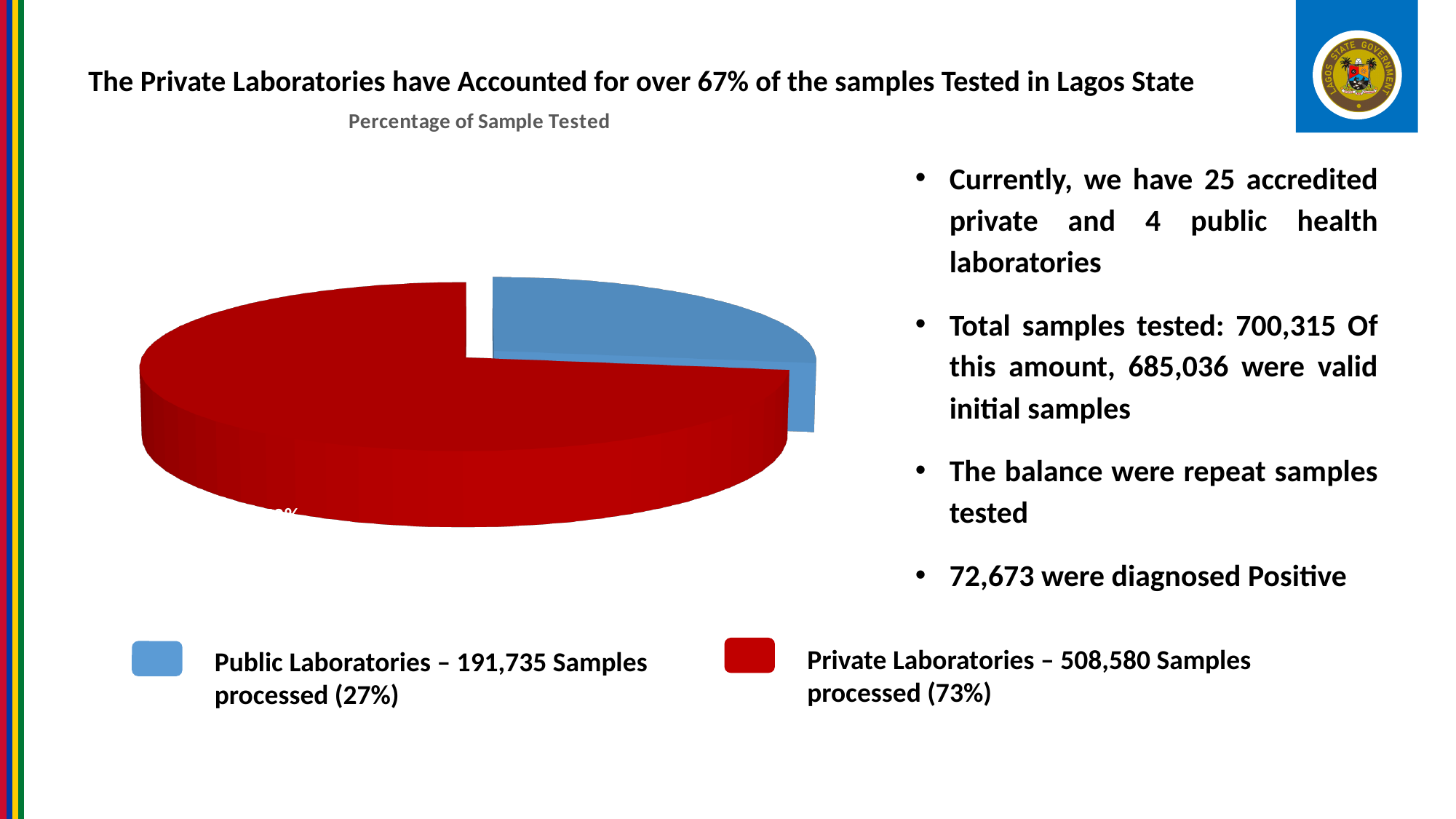
How many samples were processed by Private Laboratories? 508,580 Which processed more samples, Public Laboratories or Private Laboratories? Private Laboratories What kind of chart is shown on the slide? pie chart What colour represents Private Laboratories in the pie chart? red How many slices does the pie chart have? 2 What is the title of the chart? Percentage of Sample Tested Which category has the smallest slice of the pie? Public Laboratories Which category has the largest slice of the pie? Private Laboratories What share of the pie do Public Laboratories account for? 27% What is the difference in samples processed between Private Laboratories and Public Laboratories? 316,845 What share of the pie do Private Laboratories account for? 73% How many samples were processed by Public Laboratories? 191,735